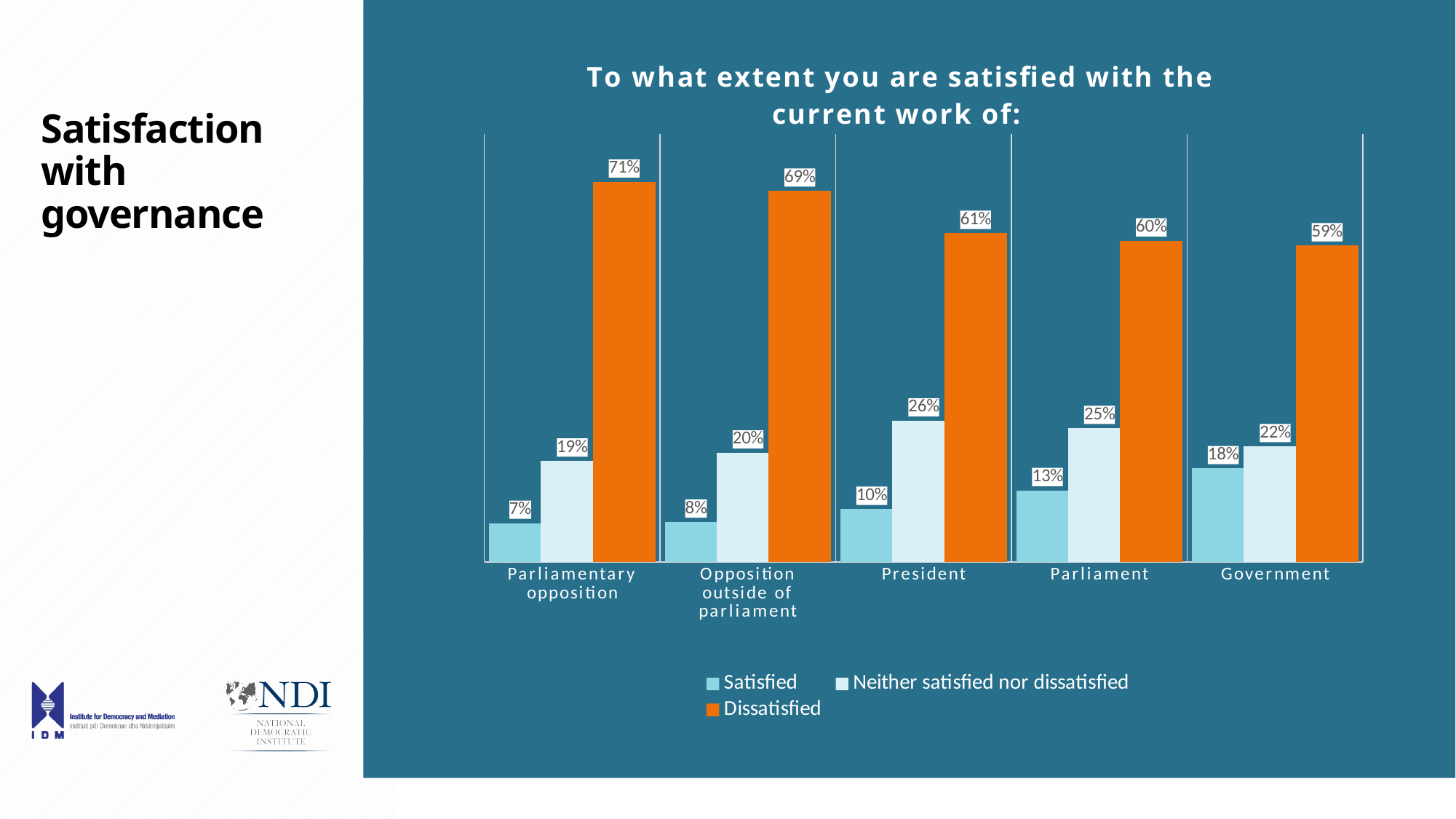
How many series does the legend list? 3 Which category has the lowest 'Dissatisfied' value? Government What is the 'Neither satisfied nor dissatisfied' value for the Government? 22% What kind of chart is shown on the slide? Bar chart What is the 'Satisfied' value for the President? 10% Which colour represents the 'Dissatisfied' series? Orange Do the 'Dissatisfied' values rise or fall from left to right across the categories? Fall What is the difference between the 'Dissatisfied' values for the Parliamentary opposition and the Government? 12% How many categories are shown on the x axis? 5 What percentage of respondents are dissatisfied with the current work of the Parliamentary opposition? 71% Which category has the highest 'Satisfied' value? Government Which is larger: the 'Neither satisfied nor dissatisfied' value for the President or for Parliament? President